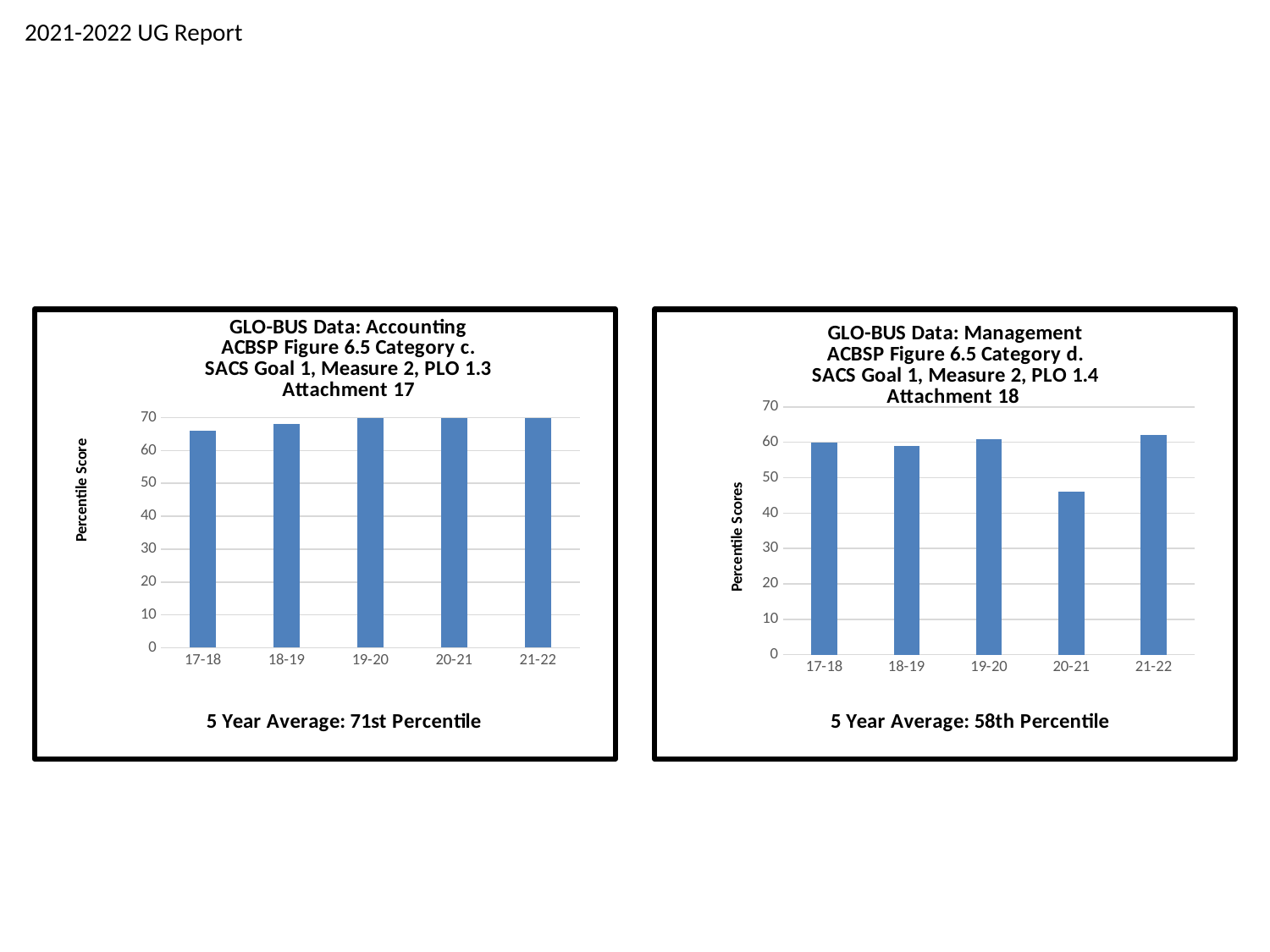
What is the y-axis label of the GLO-BUS Data: Management chart on the right? Percentile Scores What 5 year average is stated below the GLO-BUS Data: Accounting chart? 71st Percentile In the GLO-BUS Data: Accounting chart, which year has the lowest percentile score? 17-18 In the GLO-BUS Data: Management chart, which year has the lowest percentile score? 20-21 In the GLO-BUS Data: Management chart, is the value for 17-18 greater or less than 50? greater In the GLO-BUS Data: Accounting chart, is the value for 17-18 greater or less than 60? greater How many academic years are plotted in the GLO-BUS Data: Management chart on the right? 5 In the GLO-BUS Data: Accounting chart, which is larger, the value for 17-18 or the value for 19-20? 19-20 In the GLO-BUS Data: Management chart, is the value for 20-21 greater or less than 50? less In the GLO-BUS Data: Accounting chart, do the values generally rise or fall from 17-18 to 21-22? rise What kind of chart is the GLO-BUS Data: Accounting chart on the left? bar chart In the GLO-BUS Data: Management chart, which is larger, the value for 20-21 or the value for 21-22? 21-22